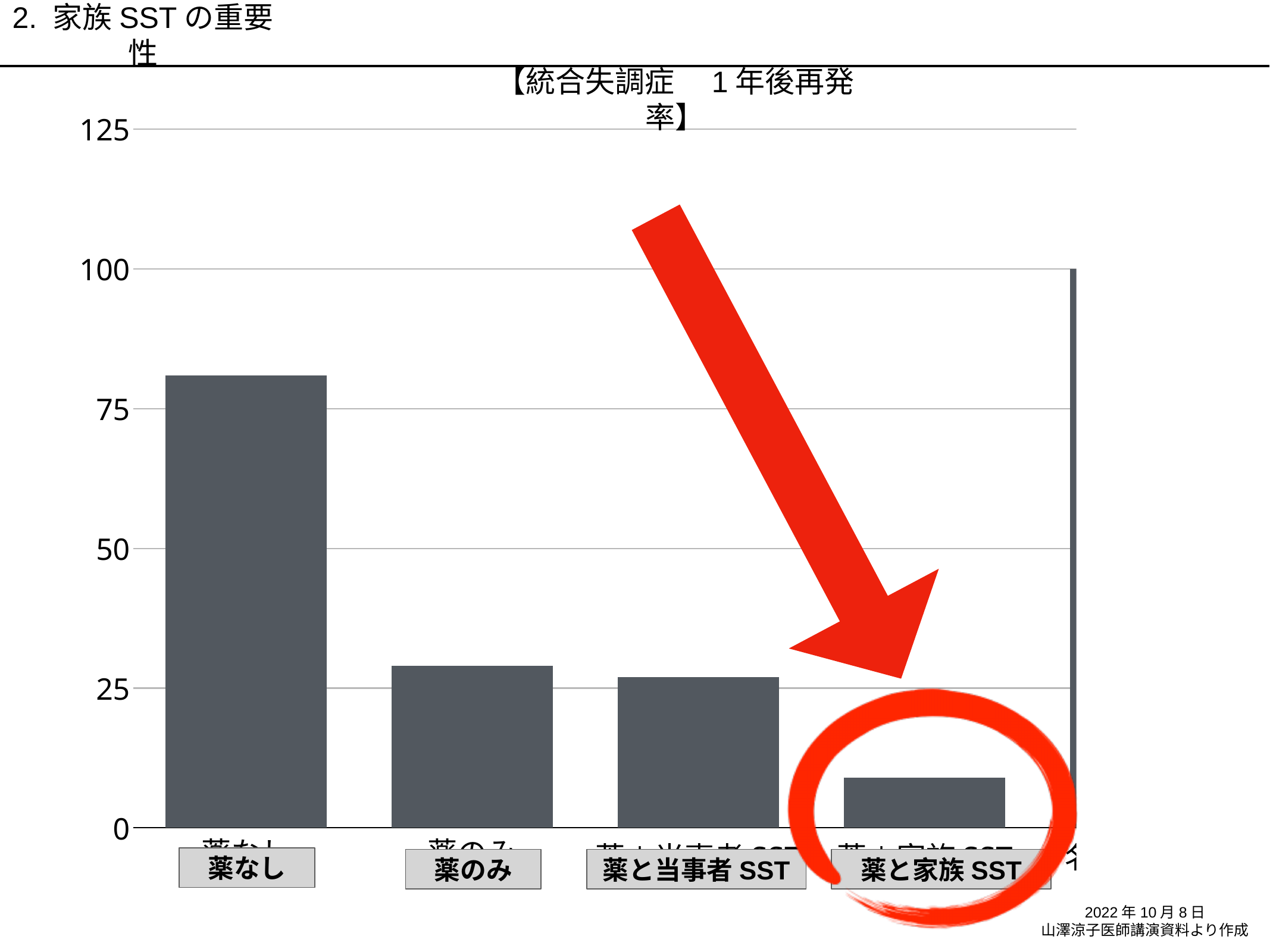
What kind of chart is shown on the slide? bar chart Which category has the lowest value in the chart? 薬と家族SST Is the value for 薬なし greater or less than 75? greater Is the value for 薬なし greater or less than 100? less Is the value for 薬と家族SST greater or less than 25? less Which is larger, the value for 薬と当事者SST or the value for 薬と家族SST? 薬と当事者SST What is the title of the chart? 【統合失調症 1年後再発率】 Which is larger, the value for 薬なし or the value for 薬のみ? 薬なし